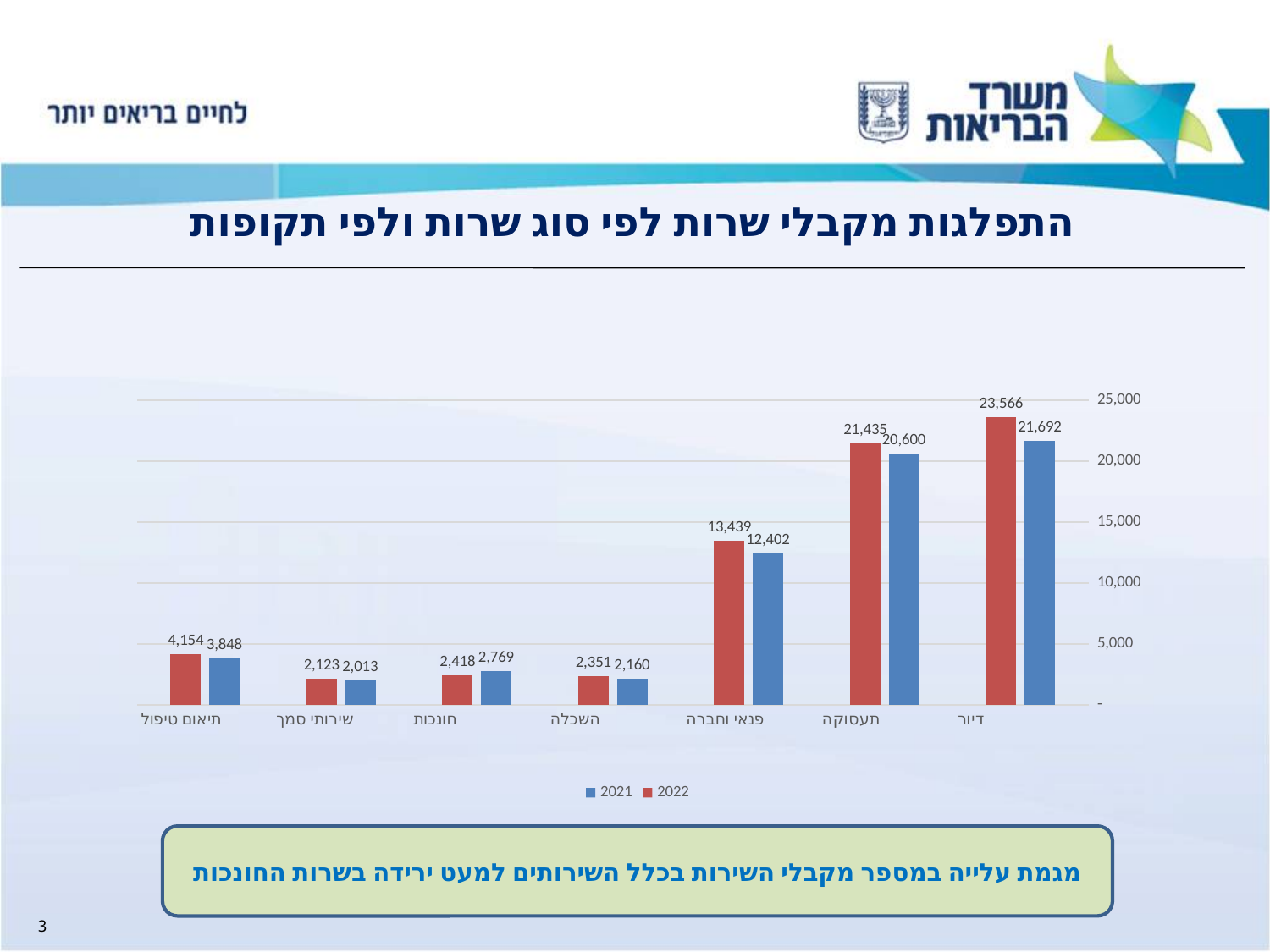
What is the 2021 value for חונכות? 2,769 Which is larger for חונכות, the 2021 value or the 2022 value? 2021 How many series does the legend list? 2 What is the 2021 value for תעסוקה? 20,600 Which category has the lowest 2021 value? שירותי סמך Is the 2022 value for תעסוקה greater or less than 20,000? greater Which colour represents the 2022 series? red How many categories are shown on the x axis? 7 What is the difference between the 2022 and 2021 values for פנאי וחברה? 1,037 What kind of chart is shown on the slide? bar chart Which category has the highest 2022 value? דיור What is the 2022 value for דיור? 23,566